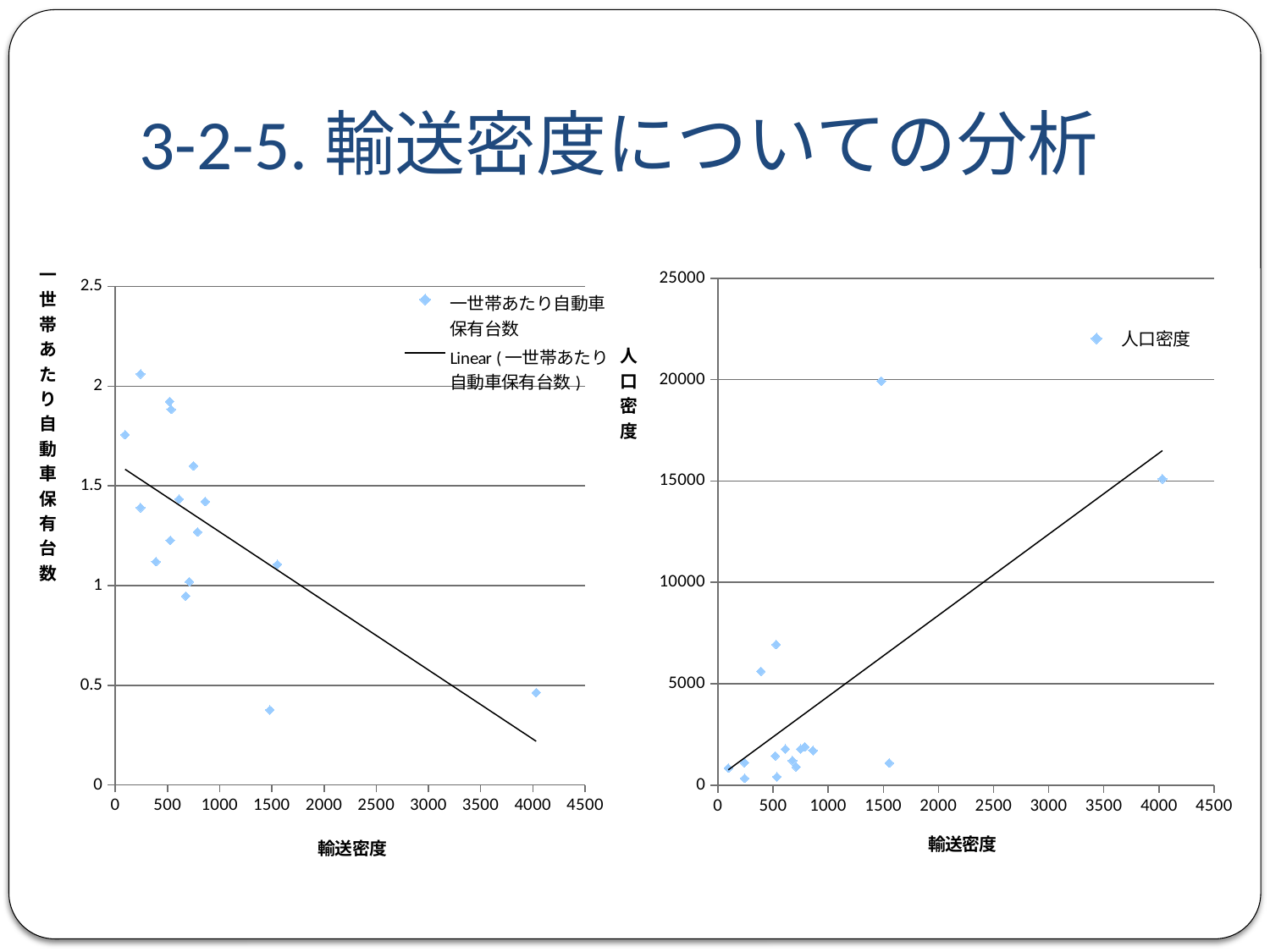
In the right chart, is the 人口密度 value of the point plotted at about 1500 on the x axis with the highest y value greater or less than 15000? greater What kind of chart is the right chart on the slide? Scatter chart In the right chart, is the 人口密度 value of the point plotted at about 4000 on the x axis greater or less than 10000? greater What is the name of the series shown in the legend of the right chart? 人口密度 What is the label on the horizontal axis of the right chart? 輸送密度 In the right chart, does the fitted linear trend line rise or fall as 輸送密度 increases? Rise In the left chart, does the fitted linear trend line rise or fall as 輸送密度 increases? Fall In the left chart, is the value of the point plotted at about 250 on the x axis with the highest y value greater or less than 2? greater How many entries does the legend of the right chart list? 1 What kind of chart is the left chart on the slide? Scatter chart How many entries does the legend of the left chart list? 2